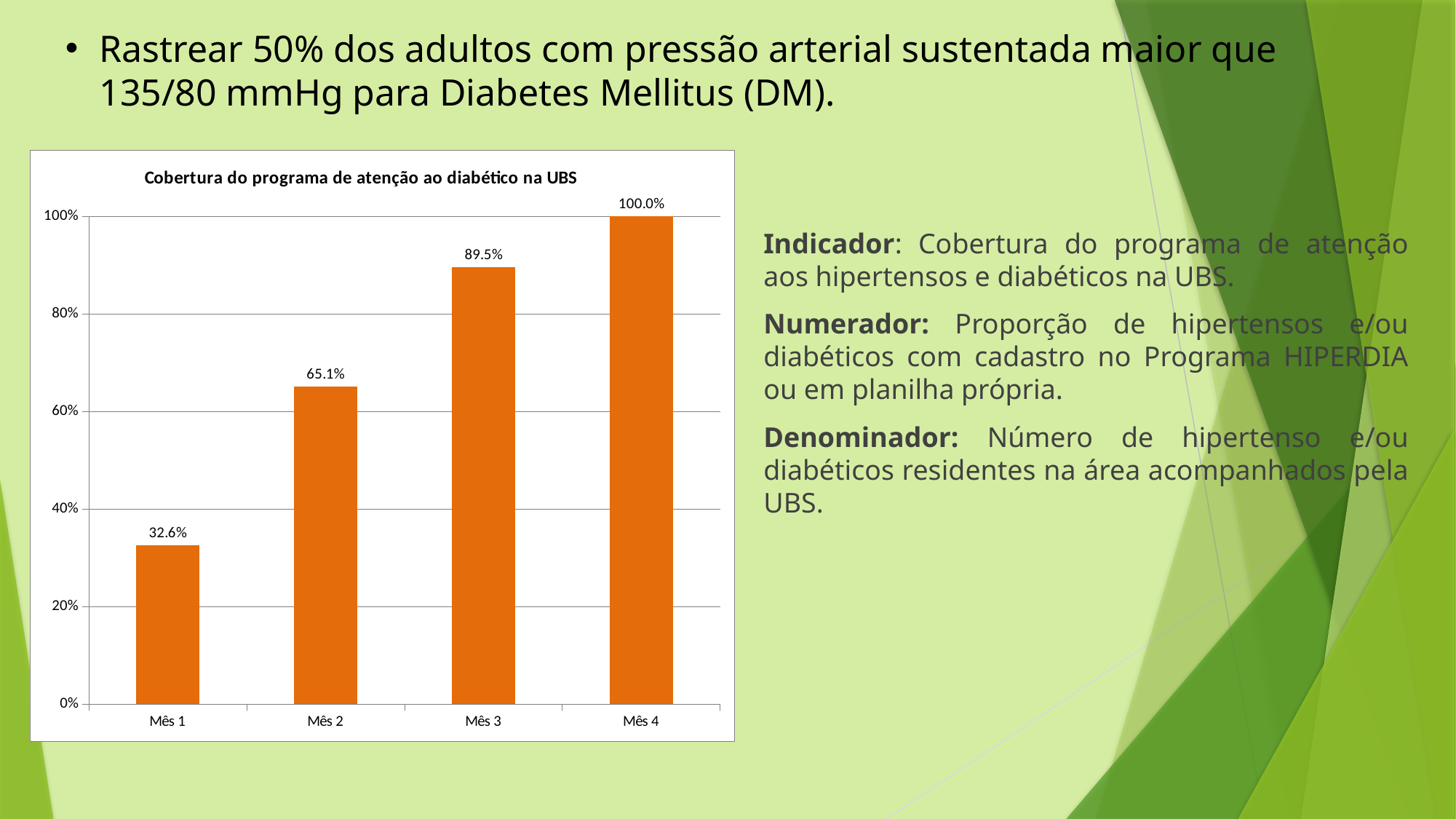
What kind of chart is shown on the slide? bar chart Which month has the highest value? Mês 4 What is the value for Mês 4? 100.0% Do the values rise or fall from Mês 1 to Mês 4? rise How many months are shown on the x axis? 4 What is the value for Mês 3? 89.5% Is the value for Mês 2 greater or less than 60%? greater Which month has the lowest value? Mês 1 What is the difference between the values for Mês 2 and Mês 1? 32.5% Which is larger, the value for Mês 2 or the value for Mês 3? Mês 3 What is the value for Mês 1? 32.6% What is the title of the chart? Cobertura do programa de atenção ao diabético na UBS